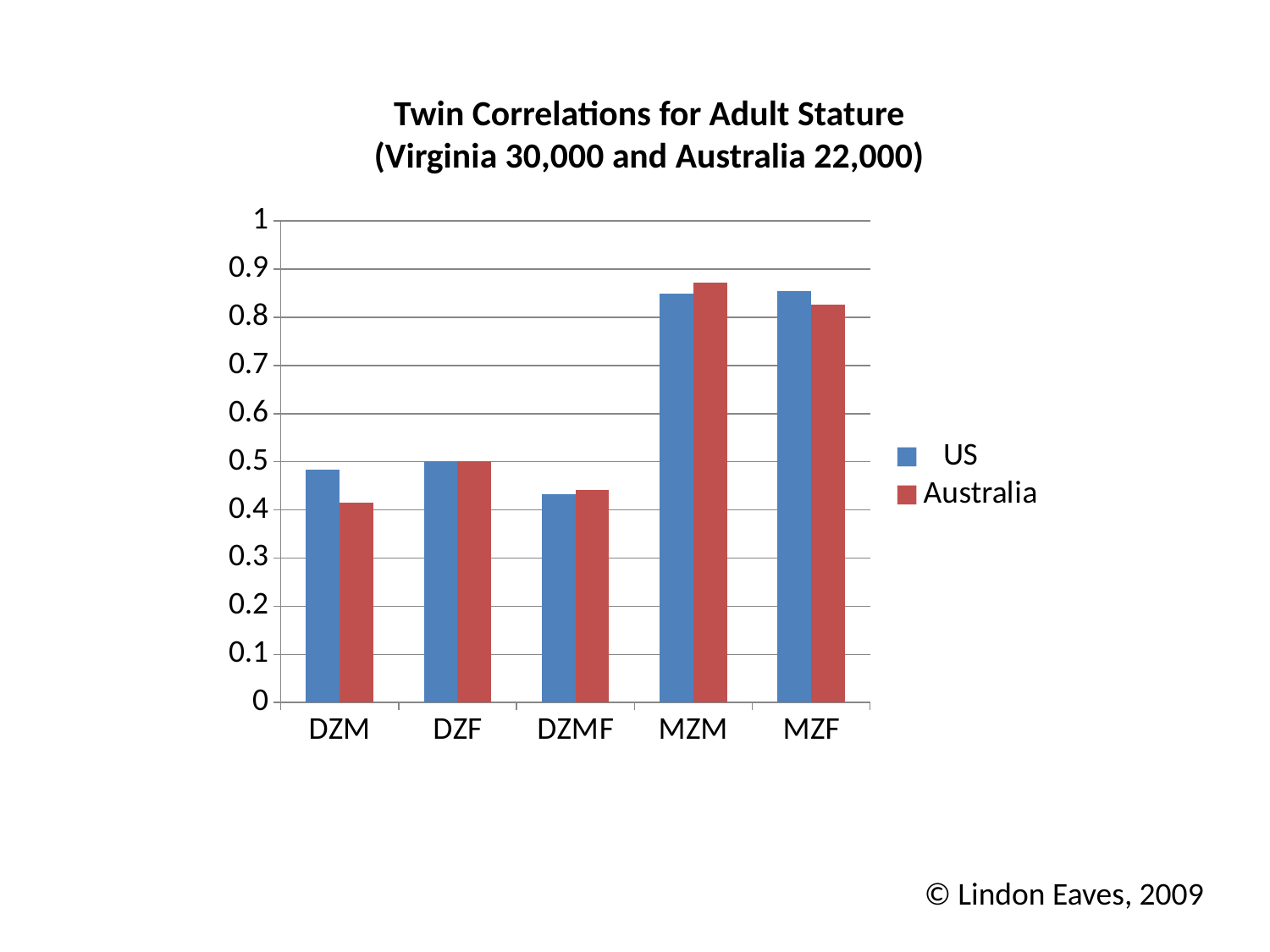
How many series does the legend list? 2 Is the US value for DZMF greater or less than 0.5? less For DZM, which is larger, the US value or the Australia value? US Which category has the lowest US value? DZMF What kind of chart is shown on the slide? bar chart Is the US value for MZF greater or less than 0.8? greater Which category has the highest Australia value? MZM What is the title of the chart? Twin Correlations for Adult Stature (Virginia 30,000 and Australia 22,000) Is the Australia value for DZM greater or less than 0.5? less Which series does the red bar represent? Australia How many twin categories are shown on the x axis? 5